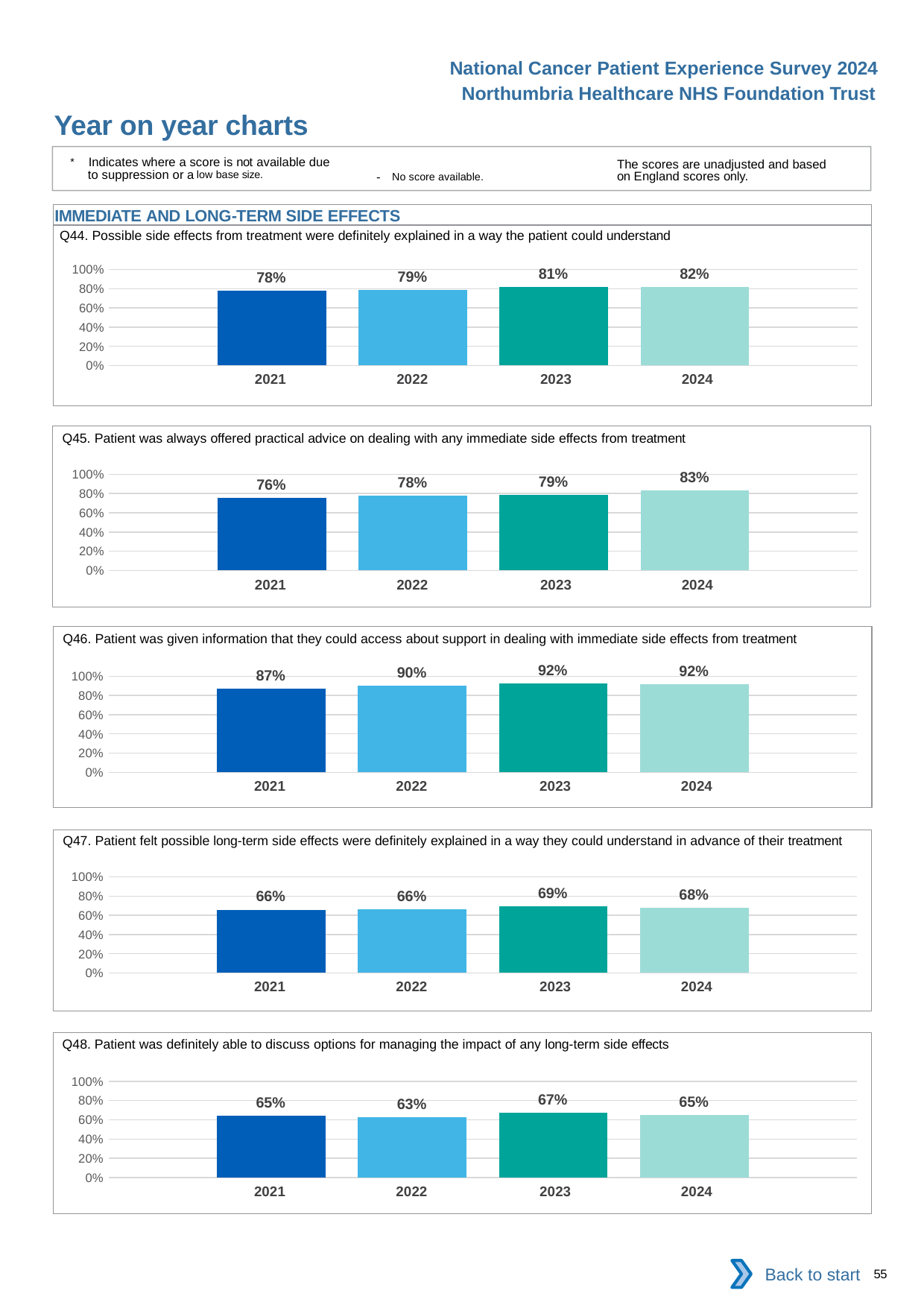
What type of chart is used for Q48? Bar chart In the Q44 chart, is the value for 2021 greater or less than 60%? greater In the Q46 chart, do the values rise or fall from 2021 to 2023? rise In the Q45 chart, what is the difference between the 2024 and 2021 values? 7 percentage points In the Q48 chart, is the value for 2023 larger than the value for 2024? Yes, 2023 (67%) is larger than 2024 (65%) How many years are shown in the Q44 chart? 4 In the Q47 chart, what is the value for 2022? 66% In the Q46 chart, what is the value for 2021? 87% In the Q47 chart, which year has the highest value? 2023 In the Q48 chart, which year has the lowest value? 2022 In the Q45 chart, which year has the highest value? 2024 In the Q44 chart, what is the value for 2024? 82%